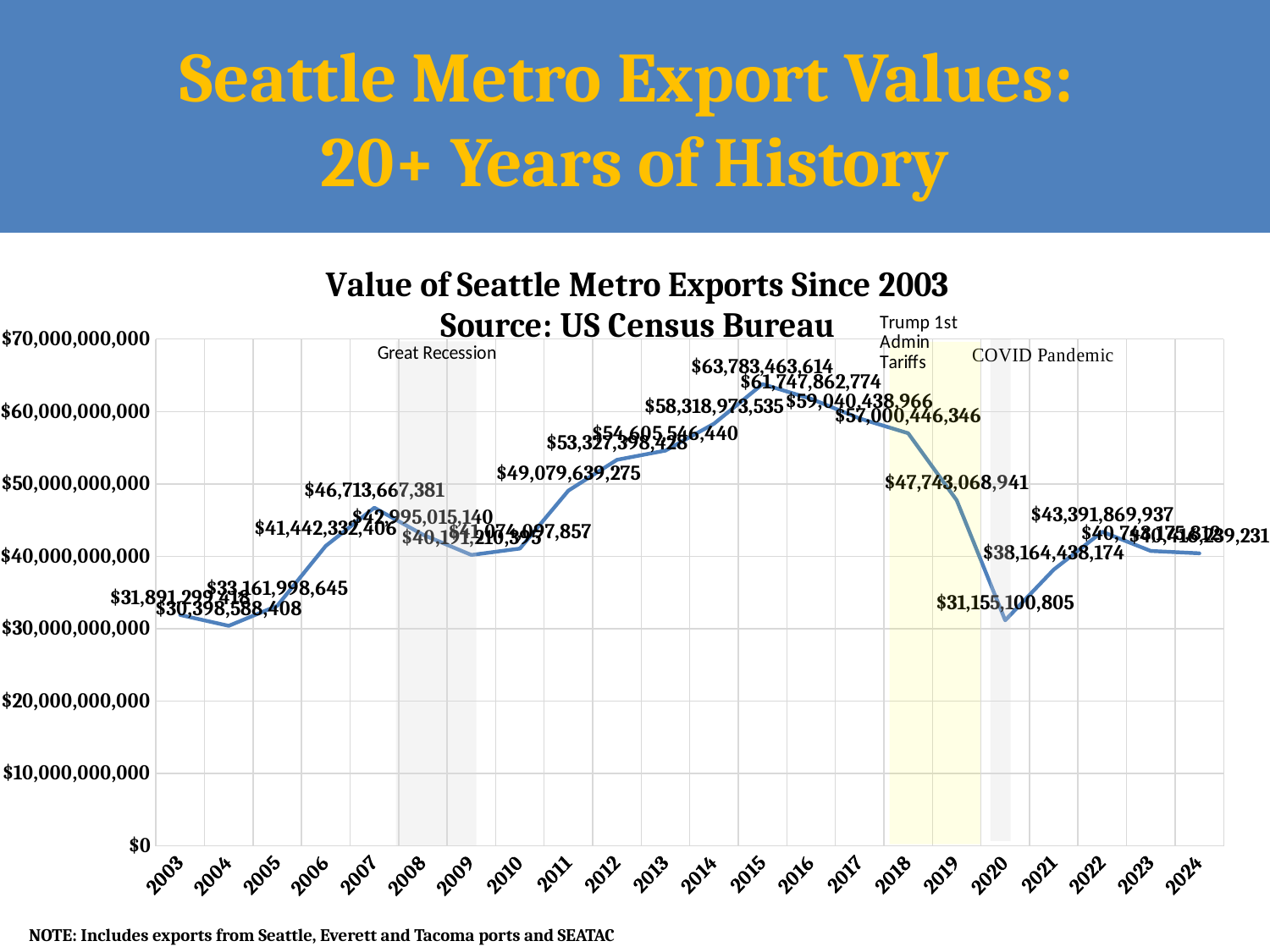
What is the export value for 2018? $57,000,446,346 Is the export value for 2024 greater or less than $50,000,000,000? less What is the export value for 2015? $63,783,463,614 What is the export value for 2007? $46,713,667,381 What is the difference between the export values for 2022 and 2021? $5,227,431,763 What kind of chart is shown on the slide? Line chart What is the export value for 2020? $31,155,100,805 How many years are plotted on the x axis? 22 What is the difference between the export values for 2015 and 2020? $32,628,362,809 Which year has the larger export value, 2019 or 2021? 2019 Do export values rise or fall from 2015 to 2020? fall Which year has the highest export value? 2015